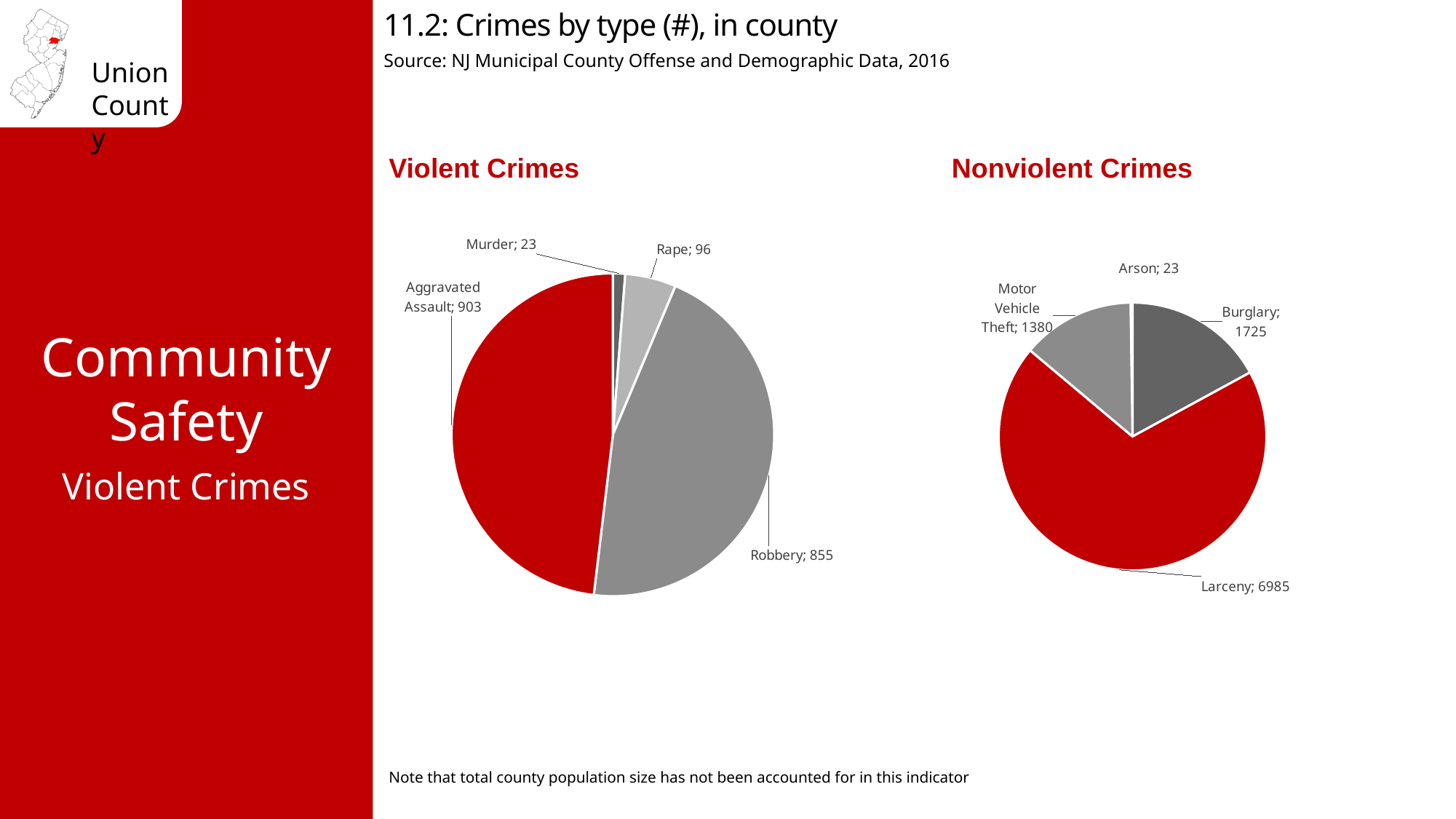
In the Nonviolent Crimes chart, what is the value for Motor Vehicle Theft? 1380 In the Violent Crimes chart, what is the value for Aggravated Assault? 903 In the Violent Crimes chart, how many robberies are shown? 855 In the Nonviolent Crimes chart, which category has the largest value? Larceny In the Violent Crimes chart, which category has the smallest value? Murder In the Nonviolent Crimes chart, what is the total of all four categories? 10113 In the Nonviolent Crimes chart, what is the difference between Burglary and Motor Vehicle Theft? 345 In the Violent Crimes chart, what is the difference between Aggravated Assault and Robbery? 48 How many categories does the Nonviolent Crimes pie chart show? 4 What type of chart is used for Violent Crimes? Pie chart In the Violent Crimes chart, which is larger, Rape or Murder? Rape What is the source cited for the charts on this slide? NJ Municipal County Offense and Demographic Data, 2016